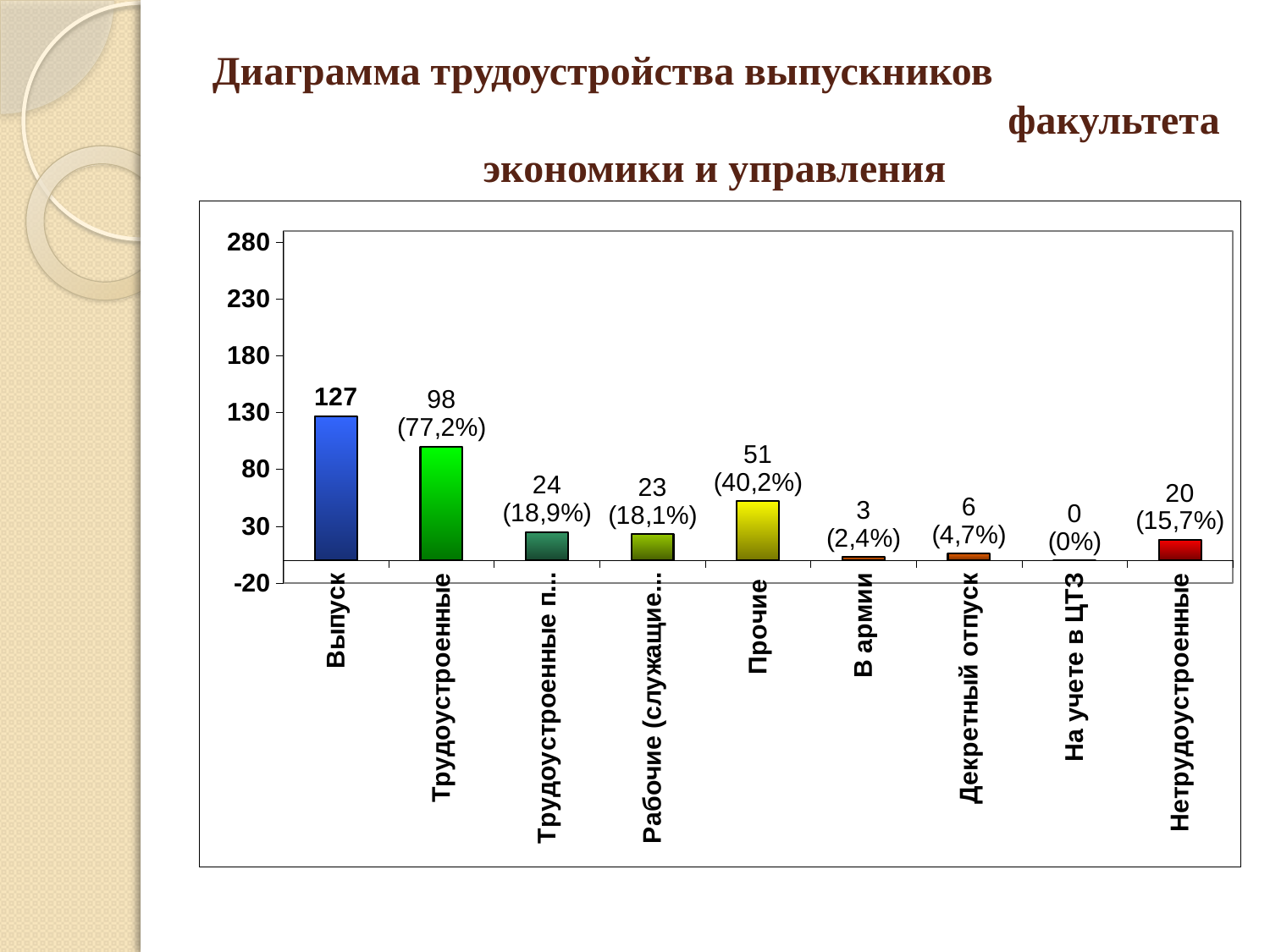
Which category has the highest value? Выпуск What is the value of the bar for Декретный отпуск? 6 What is the value of the bar for Выпуск? 127 What is the value of the bar for Нетрудоустроенные? 20 What is the value of the bar for Прочие? 51 What kind of chart is shown on the slide? bar chart What is the value of the bar for Трудоустроенные? 98 What is the difference between the values for Выпуск and Трудоустроенные? 29 Which category has the lowest value? На учете в ЦТЗ What percentage is shown for Трудоустроенные? 77,2% How many categories are shown on the x axis? 9 Which is larger, the value for Прочие or the value for Нетрудоустроенные? Прочие